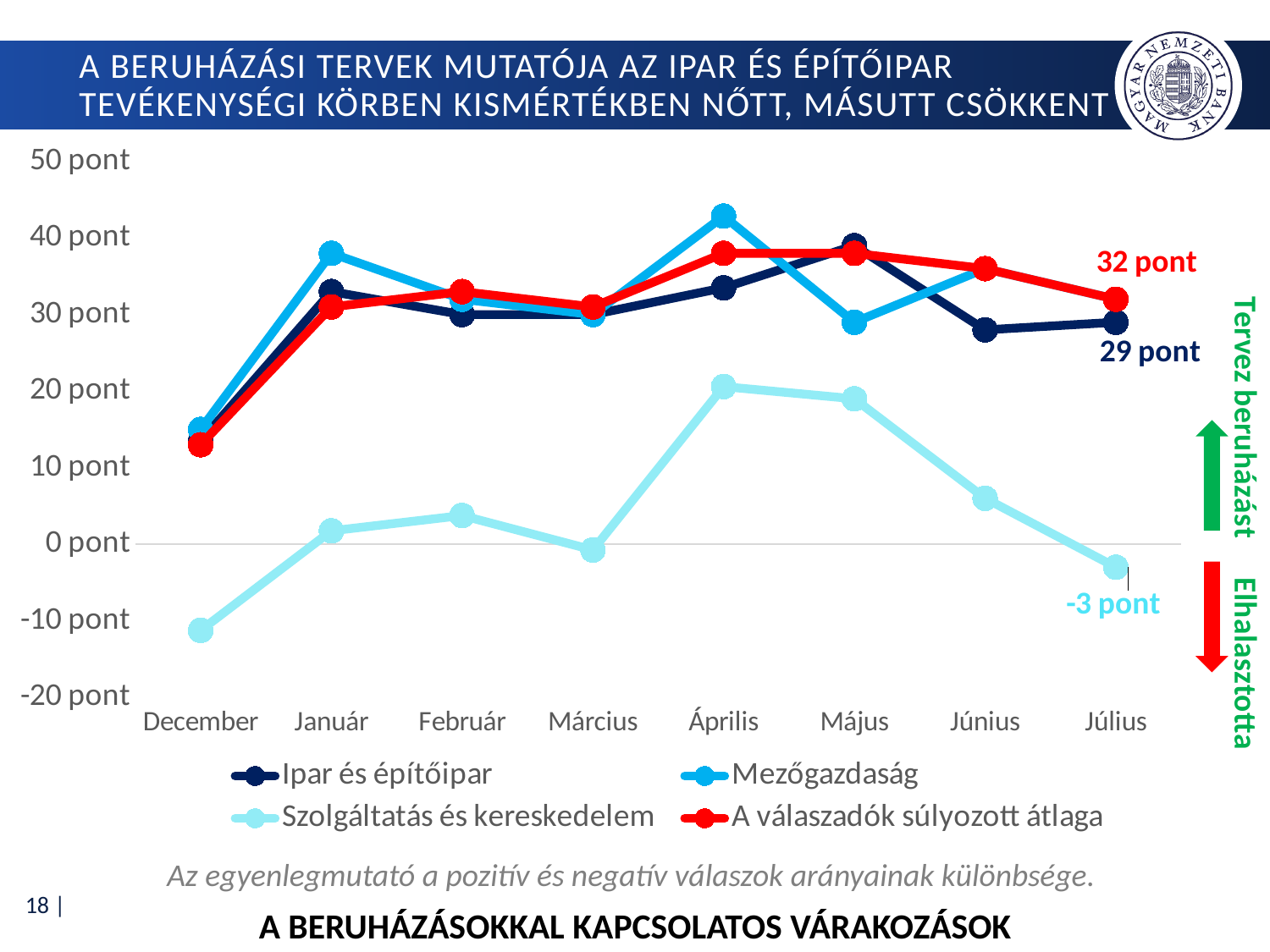
How many months are shown on the x axis? 8 Is the value for Mezőgazdaság in Április greater or less than 40 pont? greater In which month is Szolgáltatás és kereskedelem at its lowest? December What is the value for Ipar és építőipar in Július? 29 pont What is the value for Szolgáltatás és kereskedelem in Július? -3 pont Is the value for Szolgáltatás és kereskedelem in December greater or less than 0 pont? less What is the difference between A válaszadók súlyozott átlaga and Ipar és építőipar in Július? 3 pont In Július, which is larger: A válaszadók súlyozott átlaga or Ipar és építőipar? A válaszadók súlyozott átlaga Does the Szolgáltatás és kereskedelem line rise or fall from Április to Július? fall What is the value for A válaszadók súlyozott átlaga in Július? 32 pont How many series does the legend list? 4 What kind of chart is shown on the slide? line chart